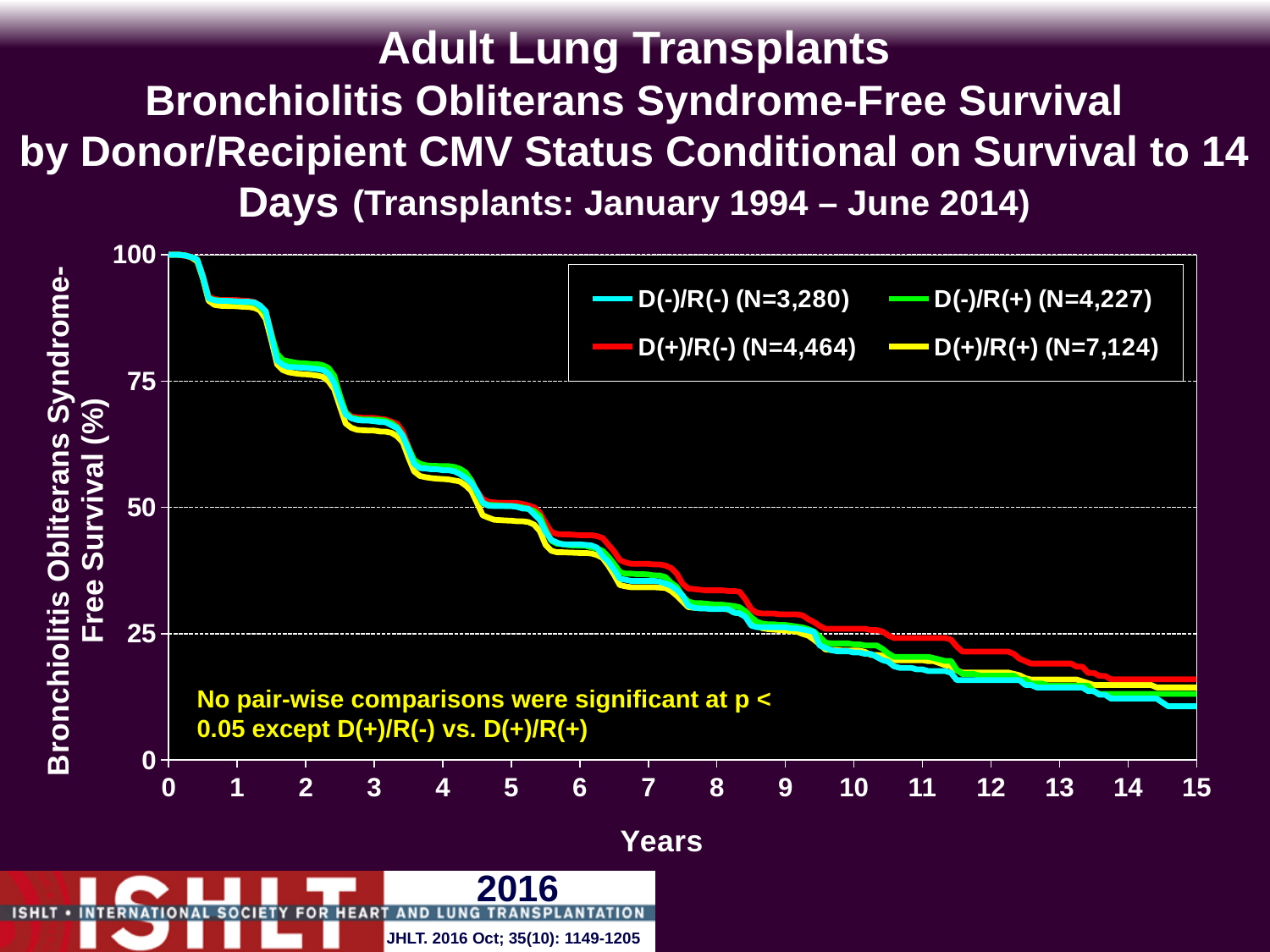
What is the label of the x axis? Years What kind of chart is shown on the slide? line chart How many series does the legend list? 4 Which series has the lowest value at year 15? D(-)/R(-) Is the value for D(-)/R(+) at year 8 greater or less than 25? greater Is the value for D(-)/R(-) at year 12 greater or less than 25? less Do the survival curves rise or fall as years increase? fall Is the value for D(+)/R(-) at year 3 greater or less than 50? greater Which series has the highest value at year 15? D(+)/R(-) What is the N shown in the legend for D(+)/R(+)? N=7,124